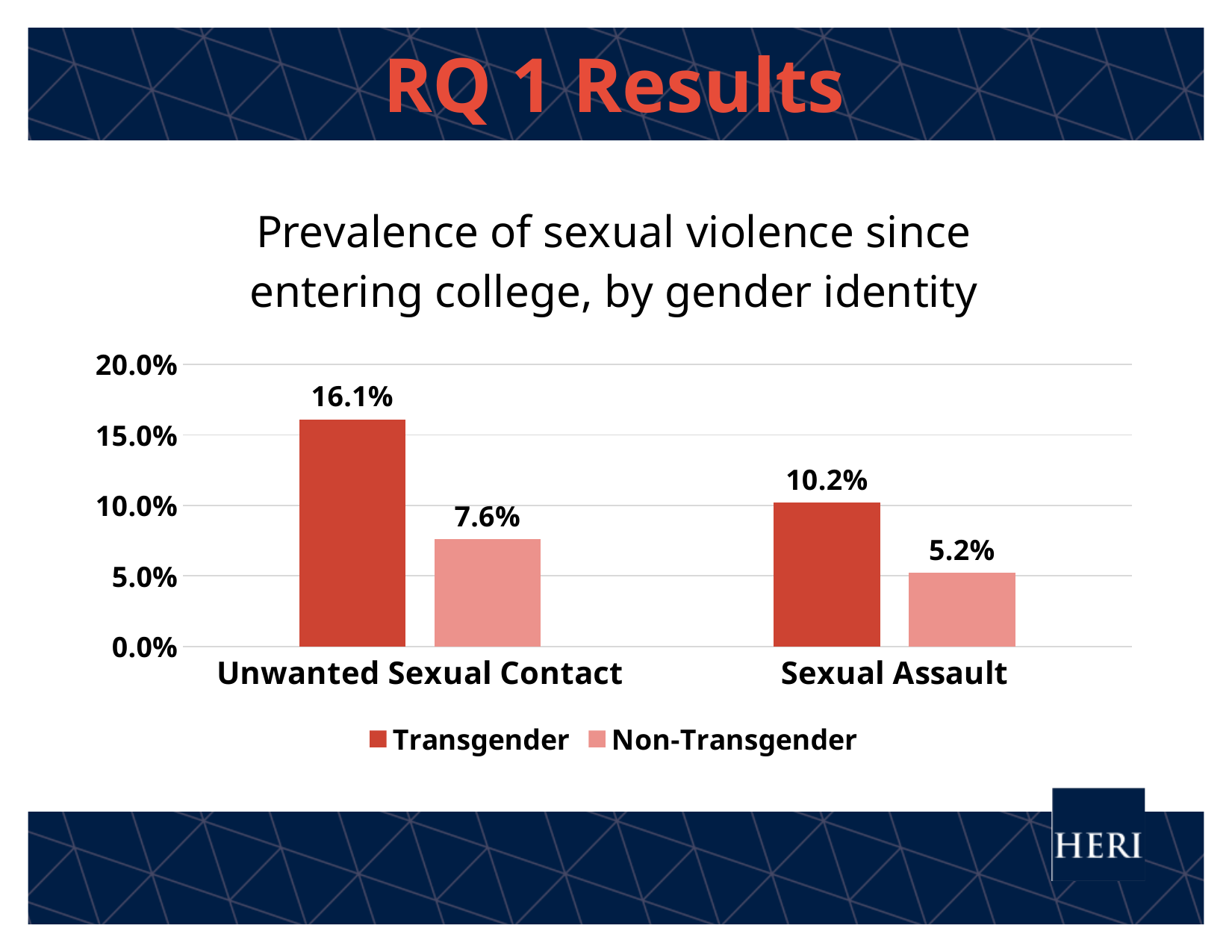
What is the value for Transgender in the Sexual Assault category? 10.2% What is the difference between the Transgender and Non-Transgender values for Sexual Assault? 5.0% How many series does the legend list? 2 Which bar has the highest value on the chart? Transgender, Unwanted Sexual Contact What is the value for Non-Transgender in the Sexual Assault category? 5.2% Which bar has the lowest value on the chart? Non-Transgender, Sexual Assault What is the difference between the Transgender and Non-Transgender values for Unwanted Sexual Contact? 8.5% What is the value for Non-Transgender in the Unwanted Sexual Contact category? 7.6% What is the value for Transgender in the Unwanted Sexual Contact category? 16.1% Which is larger: the Non-Transgender value for Unwanted Sexual Contact or the Transgender value for Sexual Assault? Transgender value for Sexual Assault What kind of chart is shown on the slide? Bar chart How many categories are shown on the x axis? 2